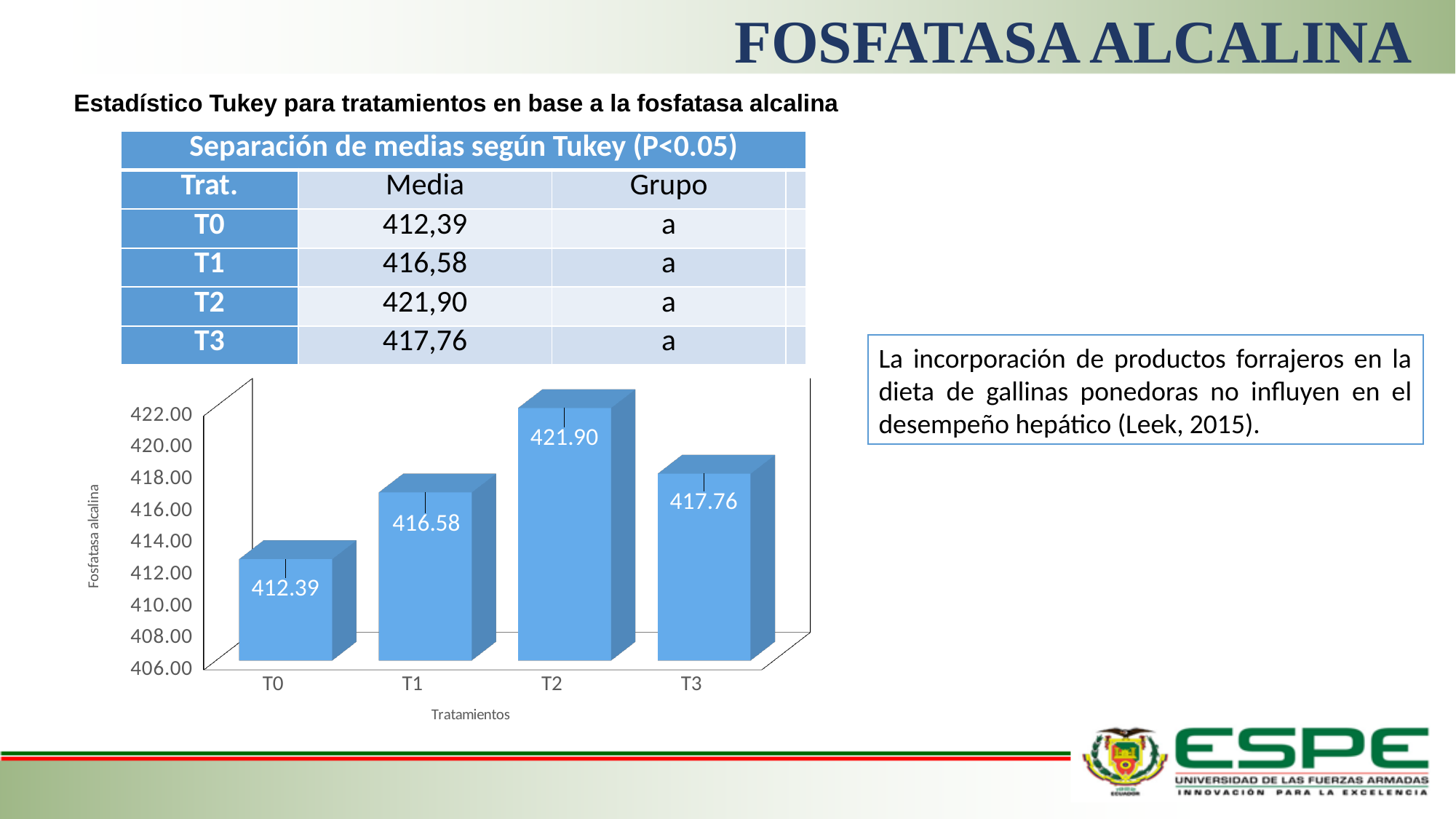
What is the value for T0 in the chart? 412.39 What is the value for T1 in the chart? 416.58 Which treatment has the highest value in the chart? T2 Which treatment has the lowest value in the chart? T0 Is the value for T2 greater or less than 420.00? greater Which is larger, the value for T1 or the value for T3? T3 What is the value for T3 in the chart? 417.76 What is the value for T2 in the chart? 421.90 What is the difference between the values for T2 and T0? 9.51 What kind of chart is shown on the slide? bar chart What is the label of the y axis of the chart? Fosfatasa alcalina How many treatments are shown on the x axis of the chart? 4